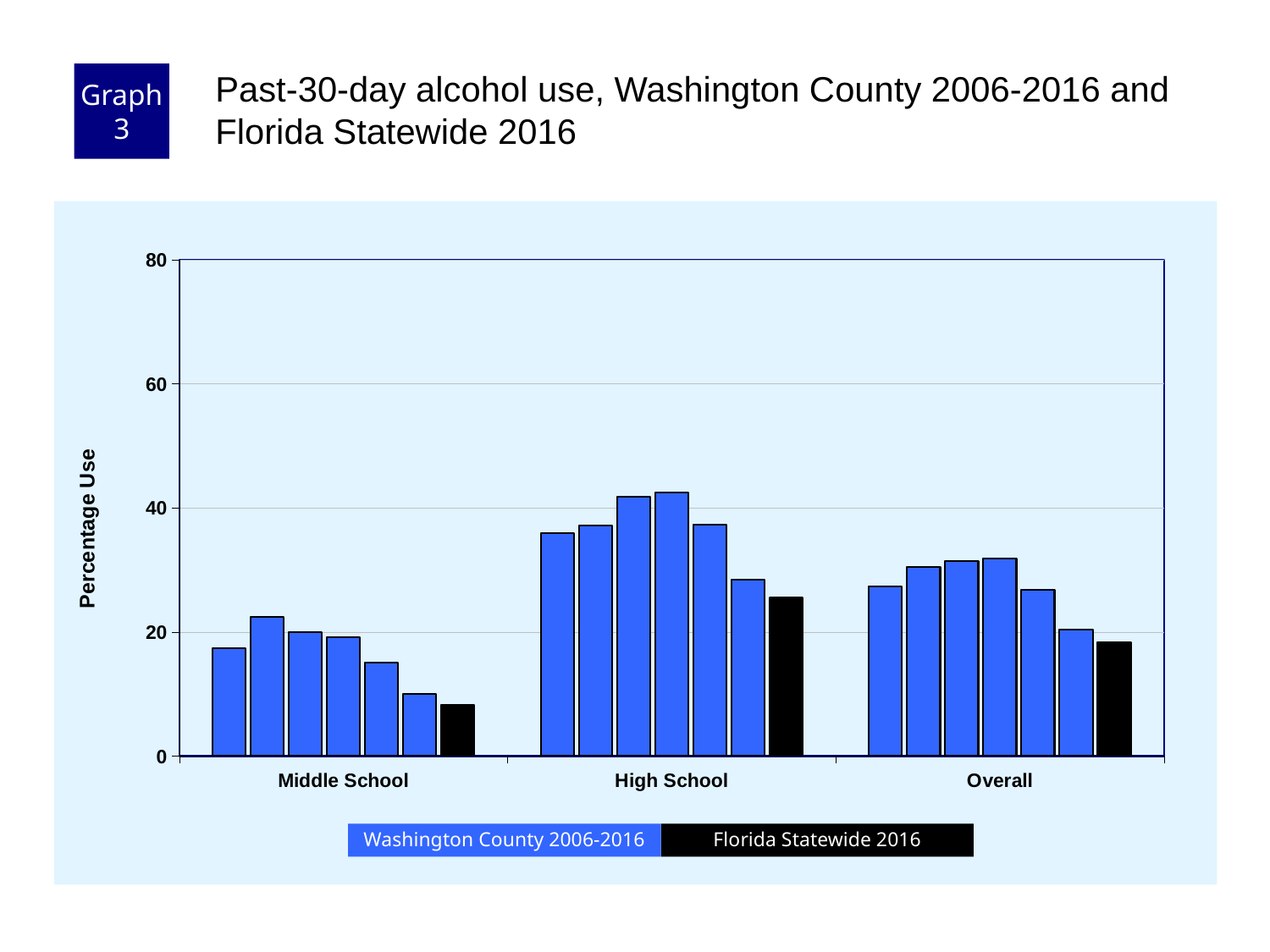
Is the Florida Statewide 2016 value for High School greater or less than 20? greater Is the Florida Statewide 2016 value for Middle School greater or less than 20? less Which category has the highest bars overall? High School Is the tallest Washington County bar for High School greater or less than 40? greater What colour are the Florida Statewide 2016 bars? black How many series does the legend list? 2 Which category has the lowest bars overall? Middle School What is the label on the y axis? Percentage Use How many categories are shown along the x axis? 3 What kind of chart is shown on the slide? bar chart Which is larger, the Florida Statewide 2016 value for High School or for Middle School? High School